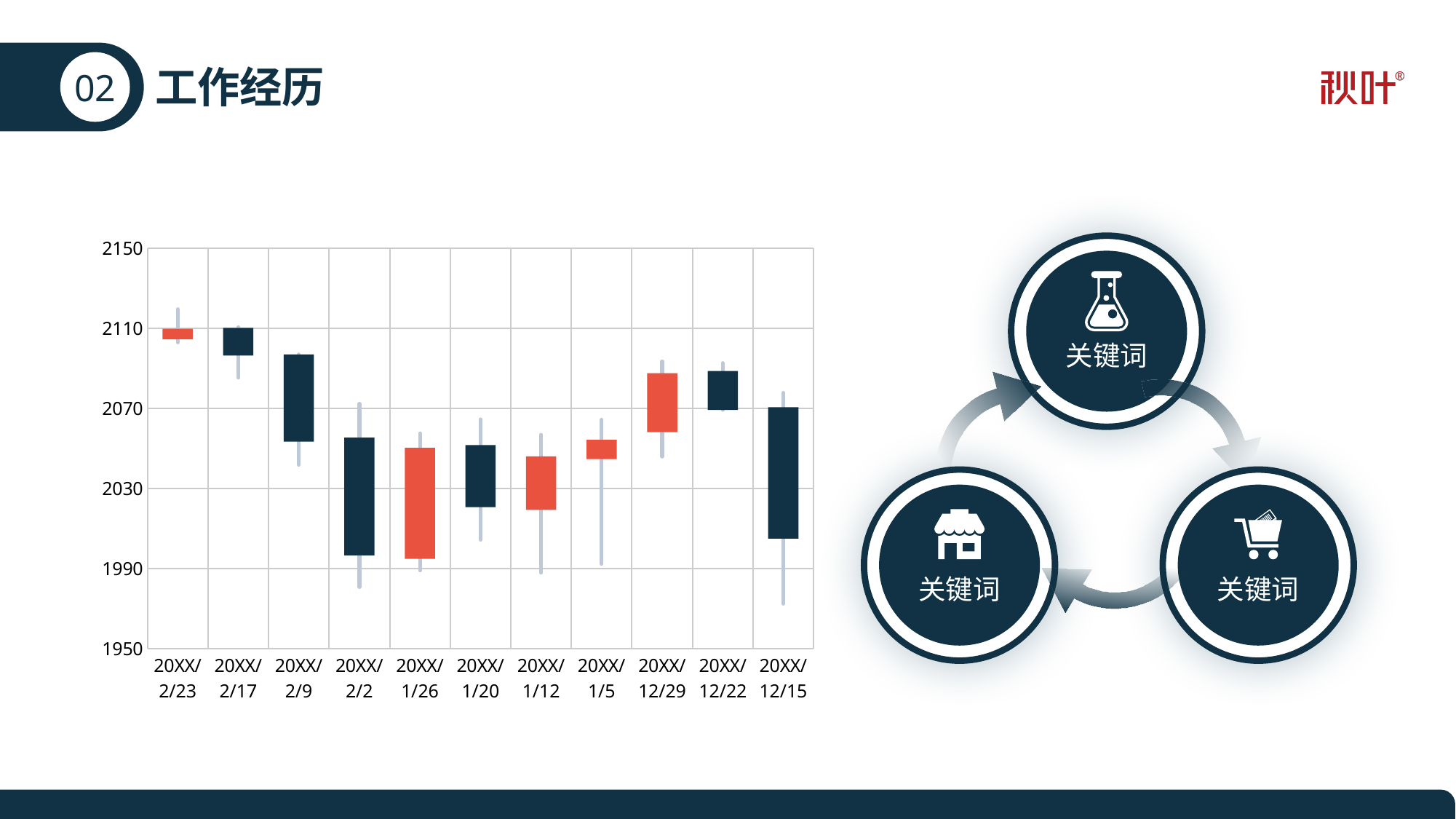
How many dates are shown on the x axis of the chart? 11 Which date has the candle body positioned highest on the chart? 20XX/2/23 What is the lowest value shown on the chart's y axis? 1950 Is the candle body for 20XX/2/23 greater or less than 2070? greater Is the top of the candle body for 20XX/1/26 greater or less than 2070? less Is the top of the candle body for 20XX/12/29 greater or less than 2070? greater Which date has the tallest candle body on the chart? 20XX/12/15 What kind of chart is shown on the slide? Candlestick (stock) chart What is the highest value shown on the chart's y axis? 2150 Which date's candle body is positioned higher, 20XX/2/23 or 20XX/1/26? 20XX/2/23